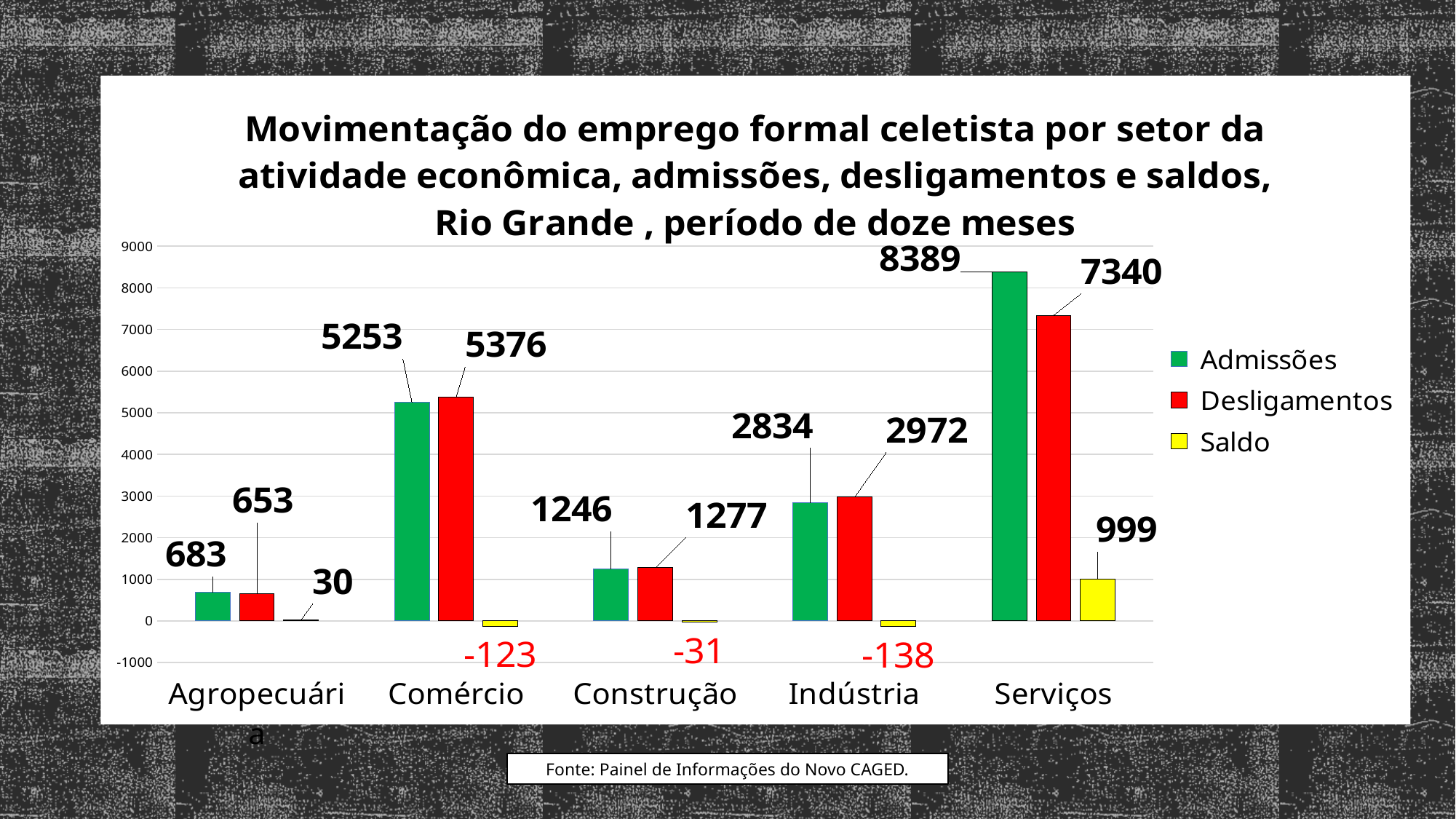
What kind of chart is shown on the slide? bar chart Which sector has the lowest Desligamentos value? Agropecuária What is the difference between Admissões and Desligamentos for Indústria? 138 What colour represents the Saldo series in the legend? yellow Is the Desligamentos value for Serviços greater or less than 7000? greater What is the Admissões value for Serviços? 8389 Which is larger for Construção, Admissões or Desligamentos? Desligamentos How many series does the legend list? 3 What is the Saldo value for Indústria? -138 How many sectors are shown on the x axis? 5 What is the Desligamentos value for Comércio? 5376 Which sector has the highest Admissões value? Serviços